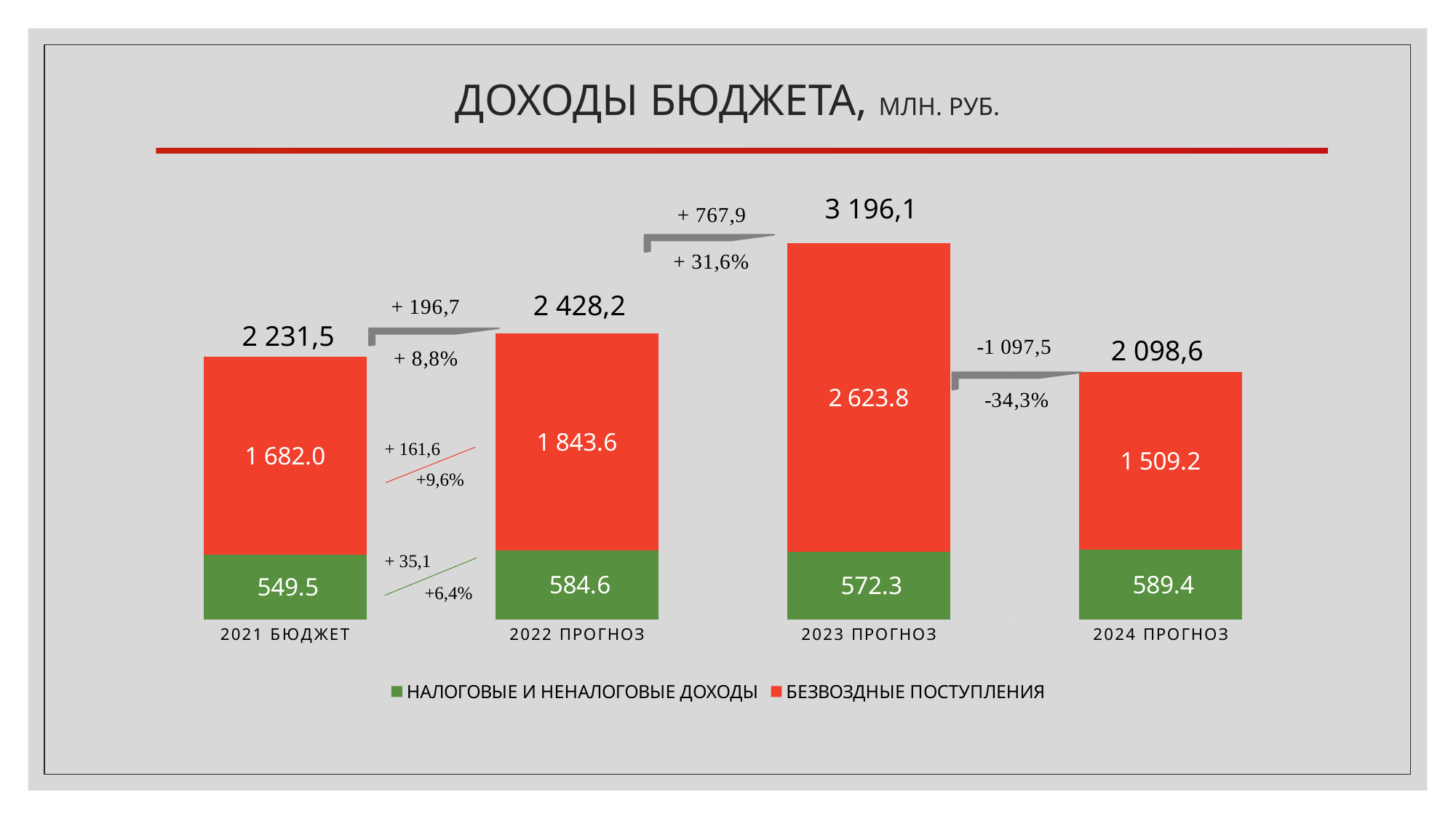
Which category has the lowest value for НАЛОГОВЫЕ И НЕНАЛОГОВЫЕ ДОХОДЫ? 2021 БЮДЖЕТ What is the value of БЕЗВОЗДНЫЕ ПОСТУПЛЕНИЯ for 2024 ПРОГНОЗ? 1 509.2 What is the total shown above the stacked bar for 2022 ПРОГНОЗ? 2 428,2 Which category has the lowest total budget income? 2024 ПРОГНОЗ Which category has the highest total budget income? 2023 ПРОГНОЗ Is the value of НАЛОГОВЫЕ И НЕНАЛОГОВЫЕ ДОХОДЫ larger for 2022 ПРОГНОЗ or for 2023 ПРОГНОЗ? 2022 ПРОГНОЗ How many categories are shown on the x axis? 4 What is the value of БЕЗВОЗДНЫЕ ПОСТУПЛЕНИЯ for 2023 ПРОГНОЗ? 2 623.8 What is the difference between the БЕЗВОЗДНЫЕ ПОСТУПЛЕНИЯ values for 2023 ПРОГНОЗ and 2024 ПРОГНОЗ? 1 114.6 How many series does the legend list? 2 What kind of chart is shown on the slide? Stacked bar chart What is the value of НАЛОГОВЫЕ И НЕНАЛОГОВЫЕ ДОХОДЫ for 2021 БЮДЖЕТ? 549.5